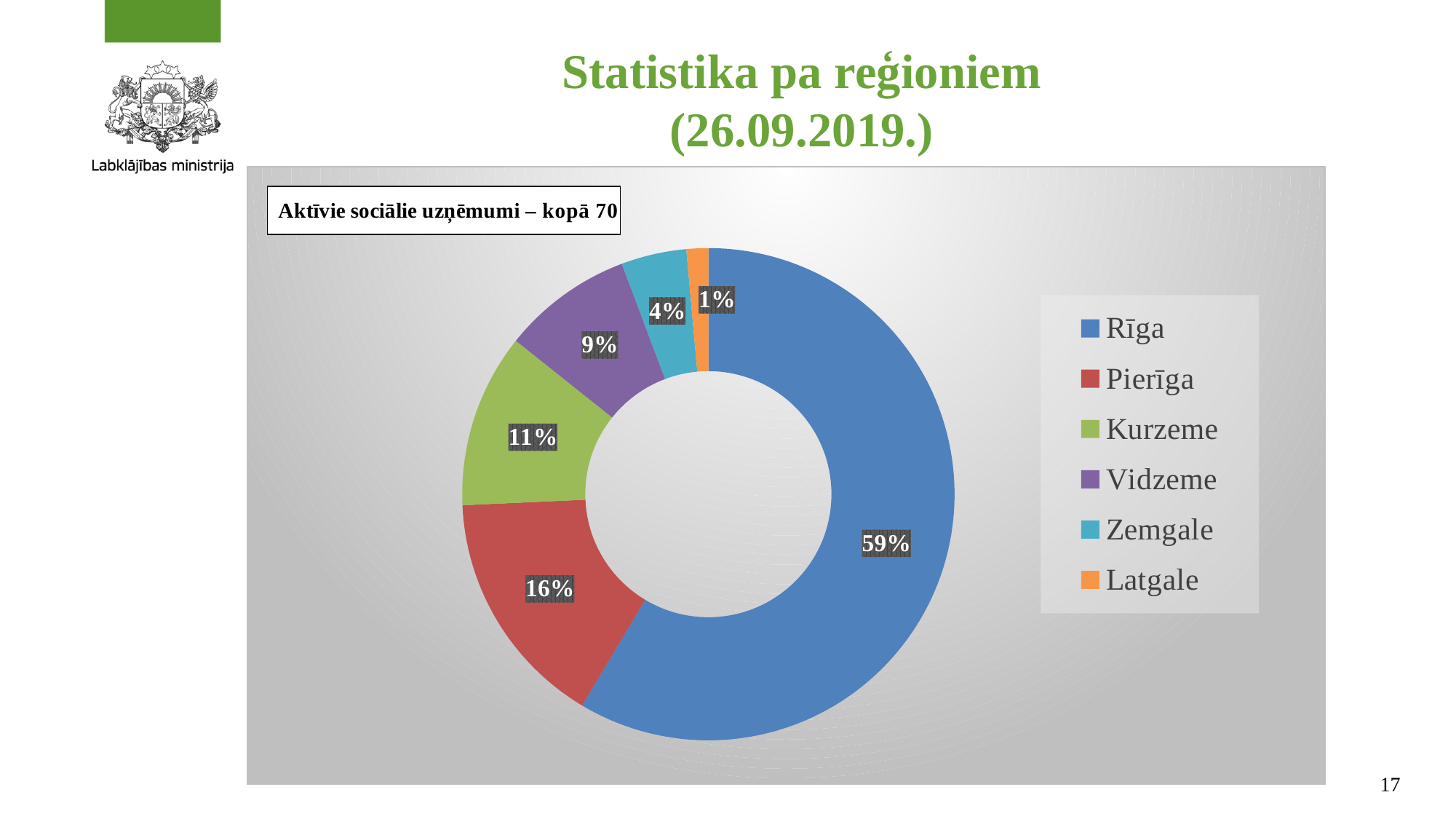
What share of the chart does Rīga account for? 59% What is the value shown for Zemgale? 4% What kind of chart is shown on the slide? Pie chart (doughnut) Which is larger, the slice for Kurzeme or the slice for Vidzeme? Kurzeme What is the value shown for Pierīga? 16% What is the title of the chart? Aktīvie sociālie uzņēmumi – kopā 70 What is the difference in percentage points between Rīga and Pierīga? 43 Which region has the smallest slice? Latgale How many regions are shown in the chart? 6 What is the value shown for Kurzeme? 11% Which region has the largest slice? Rīga What is the value shown for Vidzeme? 9%